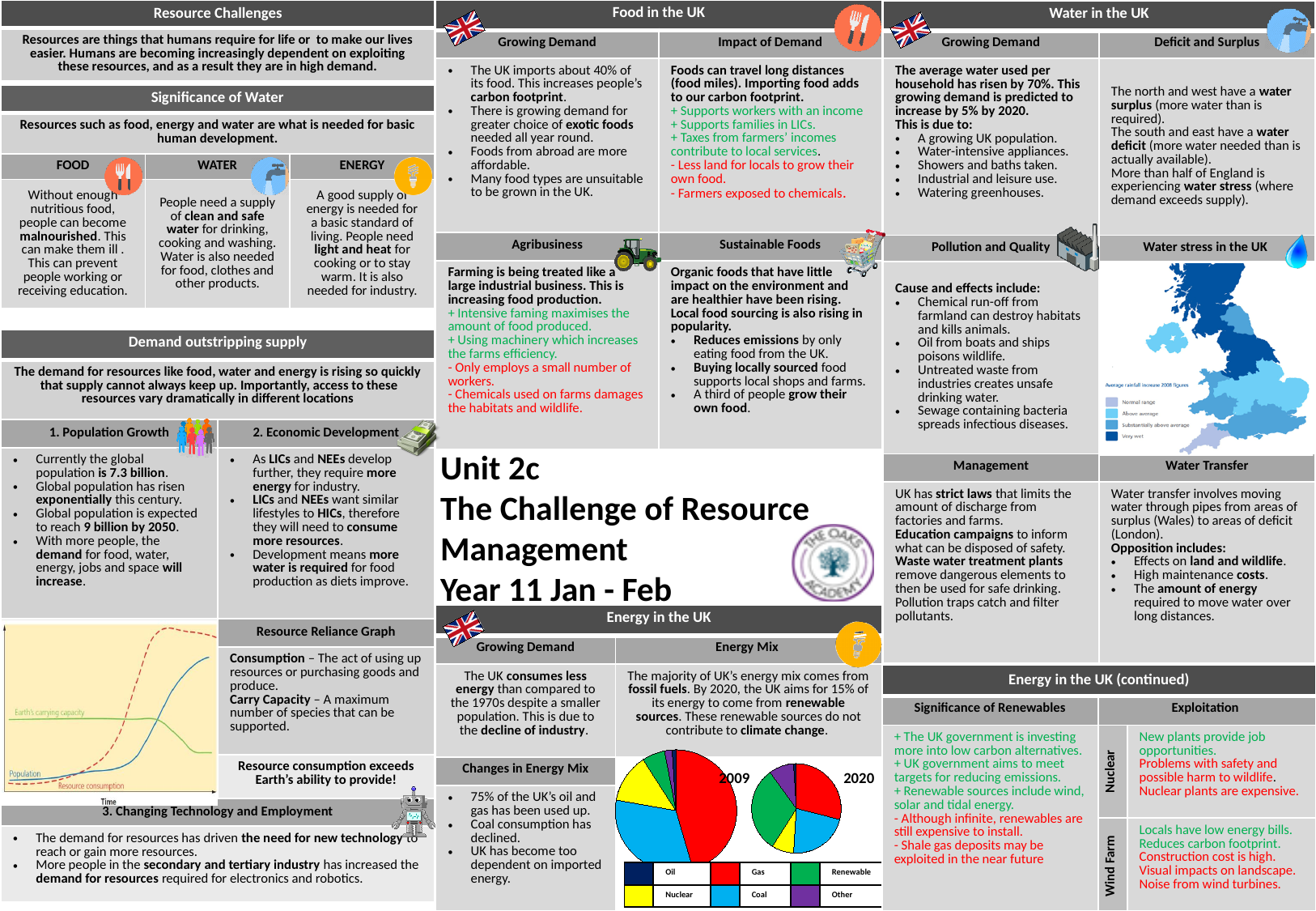
What kind of chart is the Resource Reliance Graph on the slide? Line chart In the 2009 energy mix pie chart, which is larger, the share for Coal or the share for Nuclear? Coal In the 2009 energy mix pie chart, which energy source has the largest share? Gas How many lines are plotted on the Resource Reliance Graph? 3 In the 2009 energy mix pie chart, which is larger, the share for Gas or the share for Renewable? Gas On the Resource Reliance Graph, does the Population line rise or fall over time? Rise What kind of charts are the 2009 and 2020 energy mix charts on the slide? Pie charts In the energy mix pie charts, which colour represents Gas? Red How many energy sources does the legend of the energy mix pie charts list? 6 What is the label on the x axis of the Resource Reliance Graph? Time Is the Renewable share larger in the 2009 pie chart or the 2020 pie chart? 2020 In the energy mix pie charts, which colour represents Renewable? Green